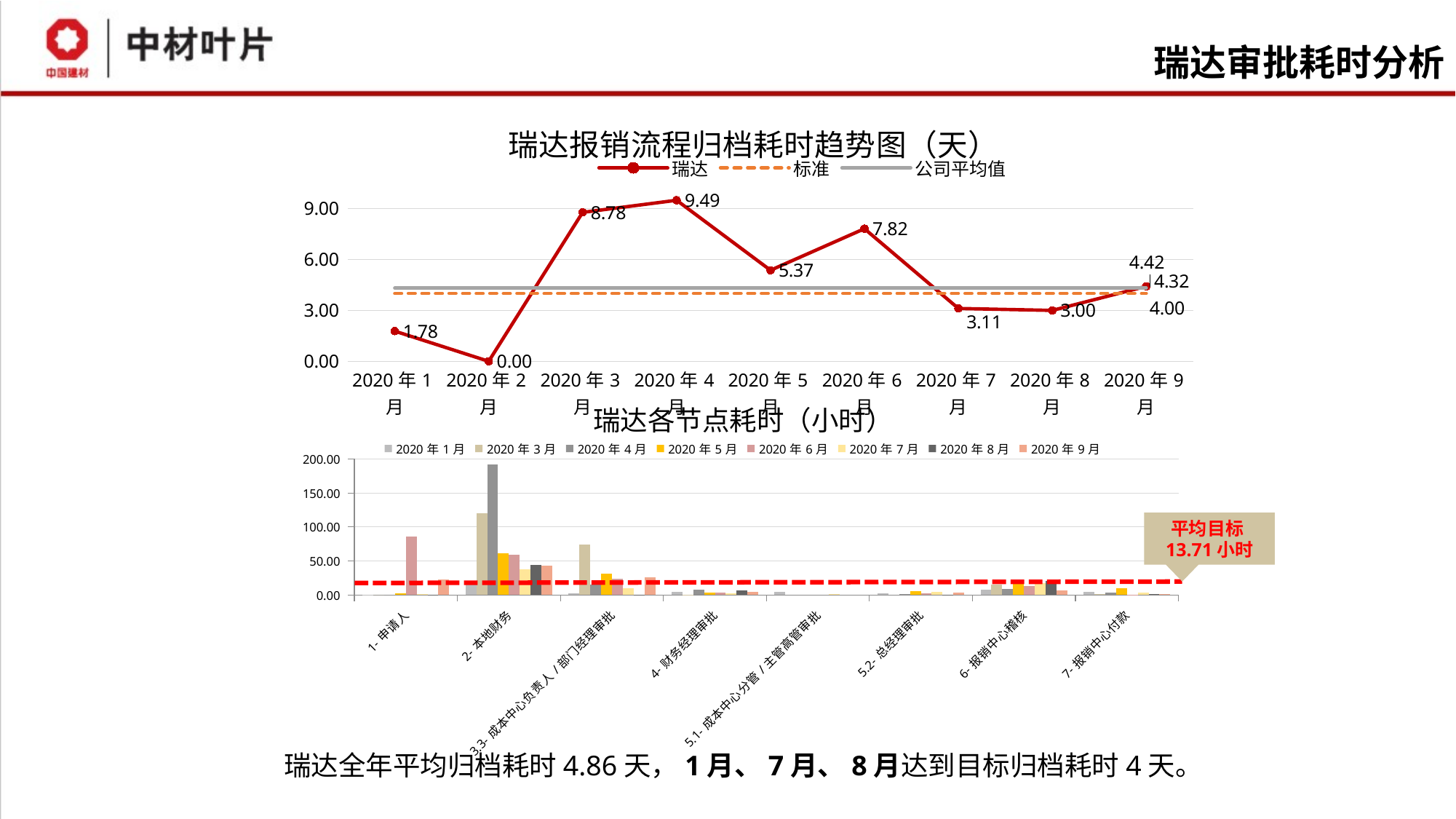
In the top chart (瑞达报销流程归档耗时趋势图), what is the difference between the 瑞达 values for 2020年4月 and 2020年3月? 0.71 In the top chart (瑞达报销流程归档耗时趋势图), which is larger, the 瑞达 value for 2020年5月 or 2020年6月? 2020年6月 In the top chart (瑞达报销流程归档耗时趋势图), which month has the highest 瑞达 value? 2020年4月 In the top chart (瑞达报销流程归档耗时趋势图), what kind of chart is it? line chart In the bottom chart (瑞达各节点耗时), what average target value is shown in the callout? 13.71 小时 In the bottom chart (瑞达各节点耗时), is the 2020年4月 value for 2-本地财务 greater or less than 150.00? greater In the top chart (瑞达报销流程归档耗时趋势图), how many series does the legend list? 3 In the top chart (瑞达报销流程归档耗时趋势图), what is the 瑞达 value for 2020年4月? 9.49 In the top chart (瑞达报销流程归档耗时趋势图), how many months are plotted on the x axis? 9 In the bottom chart (瑞达各节点耗时), what kind of chart is it? bar chart In the bottom chart (瑞达各节点耗时), how many series does the legend list? 8 In the top chart (瑞达报销流程归档耗时趋势图), which month has the lowest 瑞达 value? 2020年2月